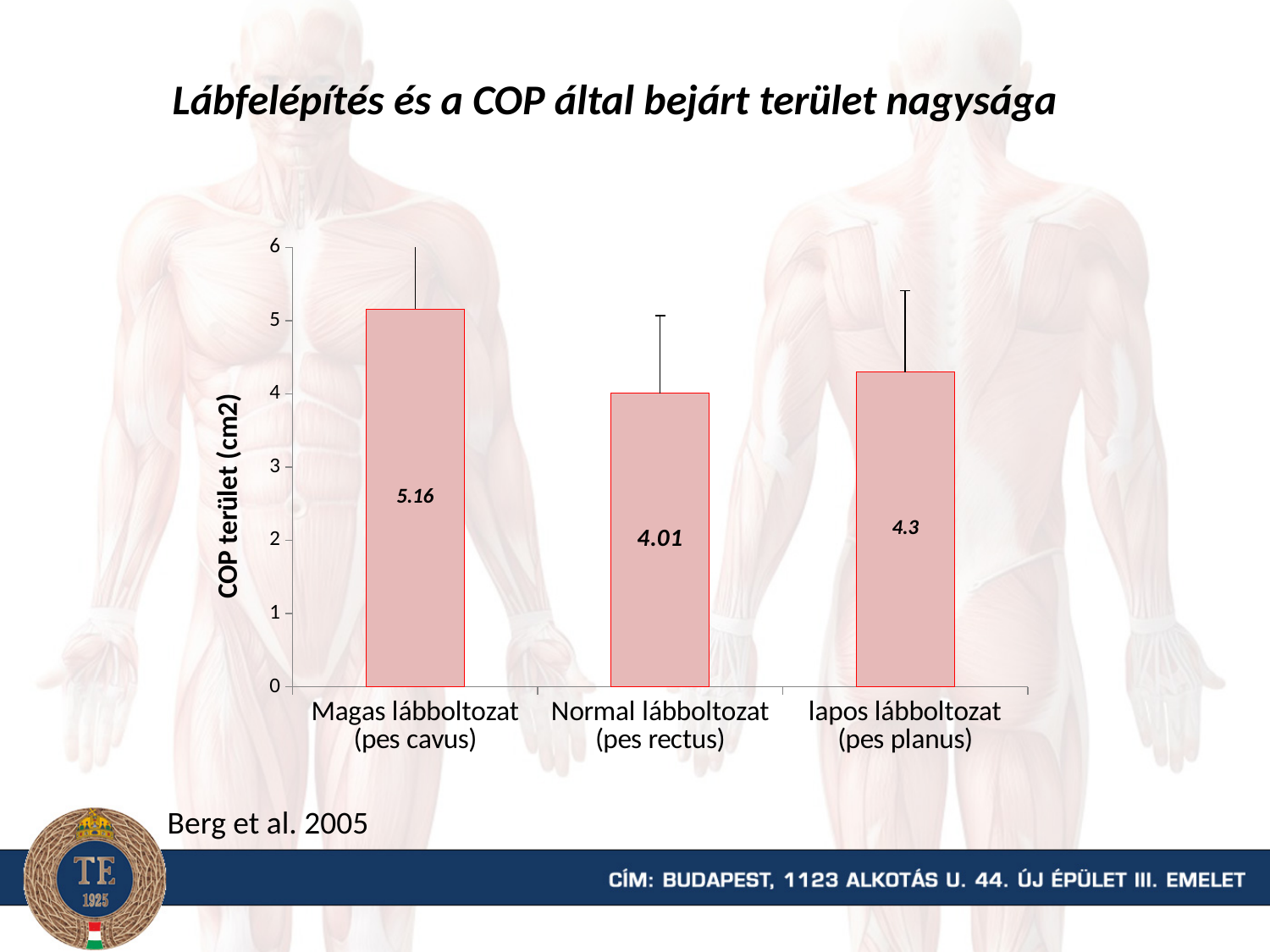
What is the difference between the COP terület values for lapos lábboltozat (pes planus) and Normal lábboltozat (pes rectus)? 0.29 How many foot-type categories are shown in the chart? 3 What is the COP terület value for Normal lábboltozat (pes rectus)? 4.01 Which foot type has the lowest COP terület value? Normal lábboltozat (pes rectus) What is the difference between the COP terület values for Magas lábboltozat (pes cavus) and Normal lábboltozat (pes rectus)? 1.15 Is the value for Magas lábboltozat (pes cavus) greater or less than 5? greater Which foot type has the highest COP terület value? Magas lábboltozat (pes cavus) What kind of chart is shown on the slide? bar chart Which has a larger COP terület value, Magas lábboltozat (pes cavus) or lapos lábboltozat (pes planus)? Magas lábboltozat (pes cavus) What is the COP terület value for Magas lábboltozat (pes cavus)? 5.16 What is the label of the vertical axis of the chart? COP terület (cm2) What is the COP terület value for lapos lábboltozat (pes planus)? 4.3